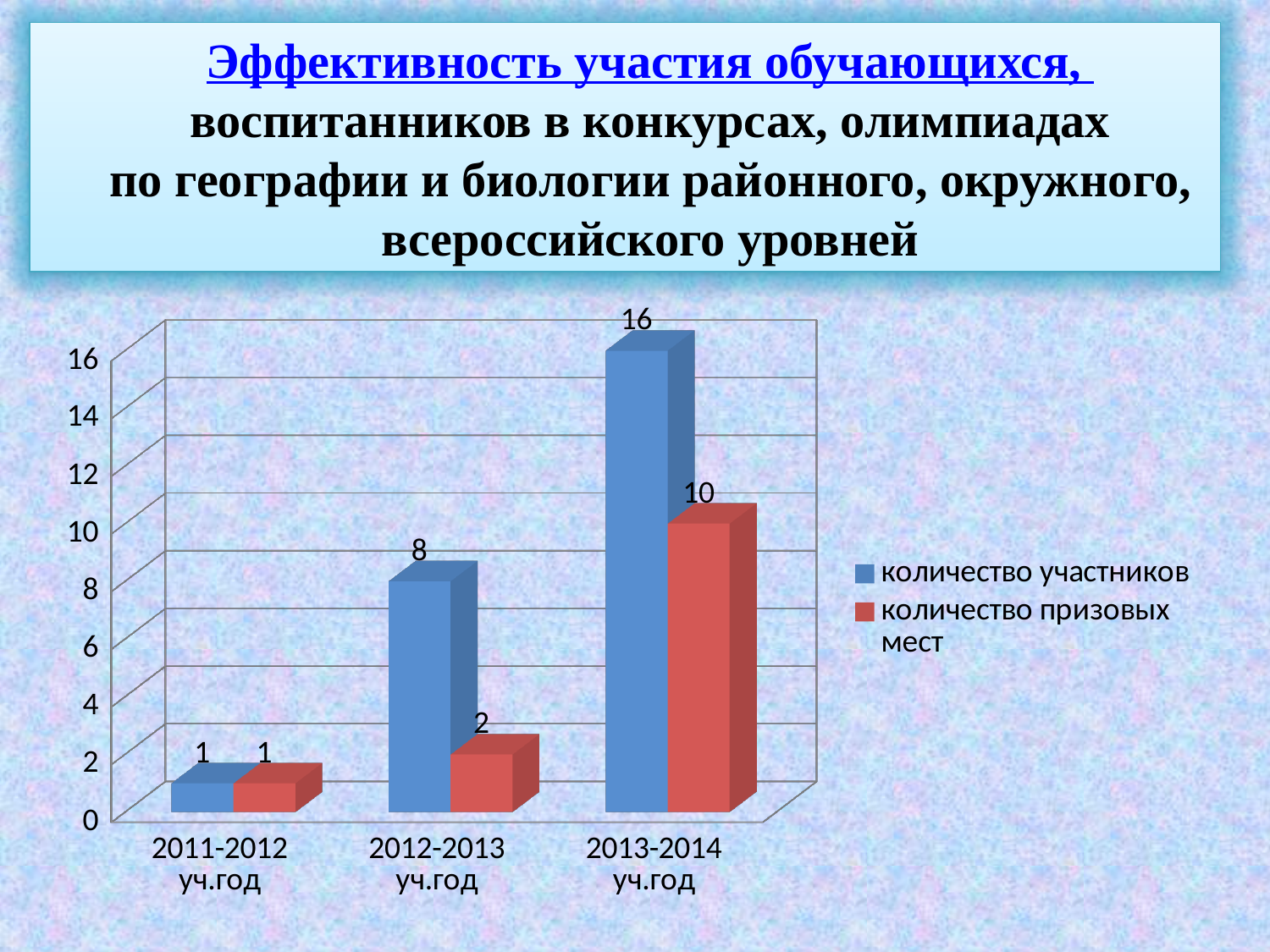
What is the number of participants (количество участников) in 2011-2012 уч.год? 1 What is the number of participants (количество участников) in 2013-2014 уч.год? 16 Which academic year has the lowest number of prize places (количество призовых мест)? 2011-2012 уч.год How many series does the legend list? 2 What is the number of prize places (количество призовых мест) in 2013-2014 уч.год? 10 Which is larger in 2012-2013 уч.год: the number of participants or the number of prize places? количество участников What is the number of prize places (количество призовых мест) in 2012-2013 уч.год? 2 What is the difference between the number of participants and the number of prize places in 2013-2014 уч.год? 6 How many academic years are shown on the x axis? 3 Does the number of participants rise or fall from 2011-2012 to 2013-2014? rise What is the difference in the number of participants between 2013-2014 уч.год and 2012-2013 уч.год? 8 Which academic year has the highest number of participants (количество участников)? 2013-2014 уч.год